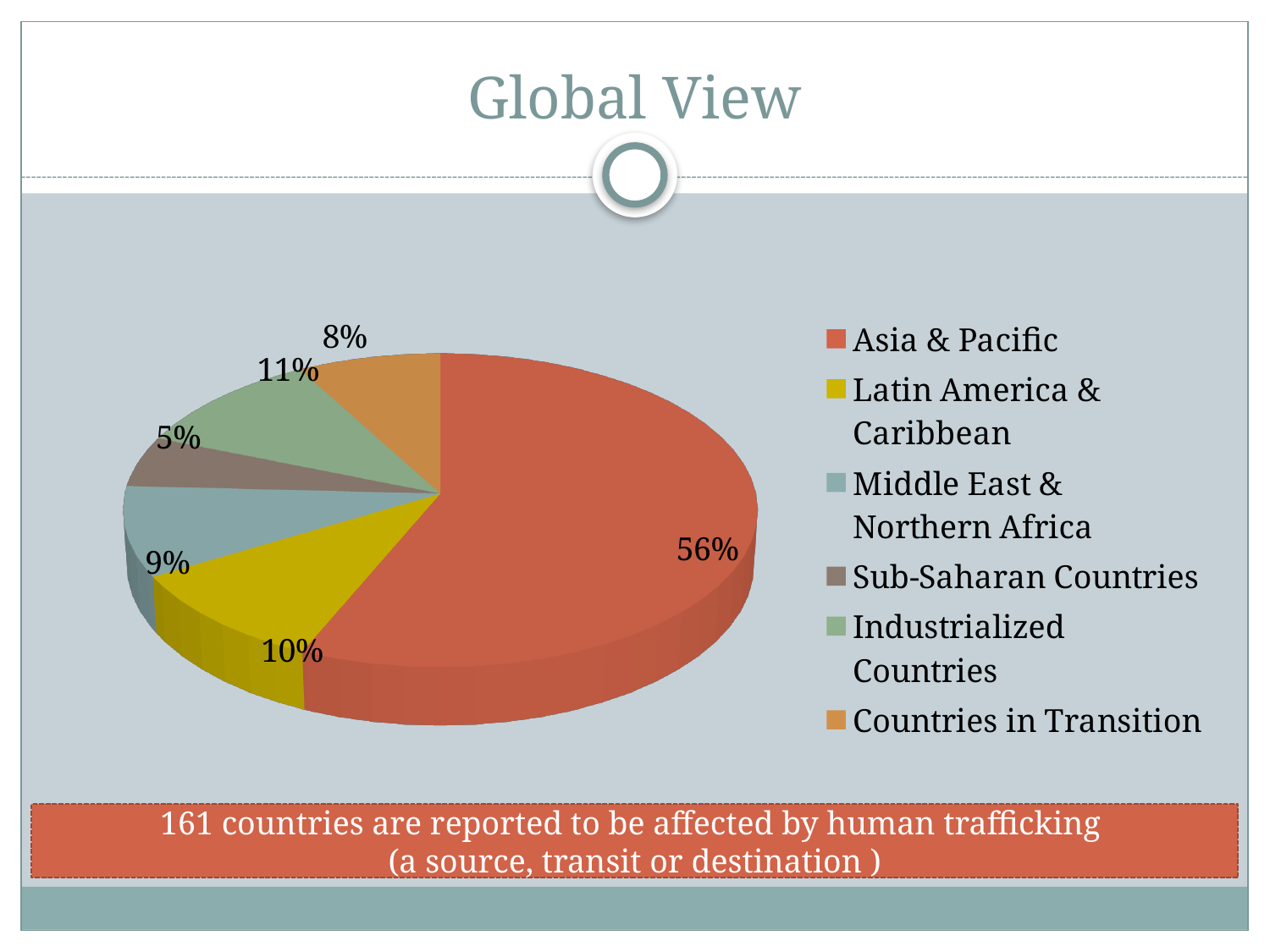
What percentage is shown for Middle East & Northern Africa? 9% Which region has the smallest slice of the pie? Sub-Saharan Countries What share of the pie does Asia & Pacific hold? 56% How many regions are shown in the pie chart? 6 What percentage is shown for Industrialized Countries? 11% What is the difference in percentage points between Asia & Pacific and Industrialized Countries? 45 What type of chart is shown on the slide? Pie chart What percentage is shown for Sub-Saharan Countries? 5% What percentage is shown for Countries in Transition? 8% Which region has the largest slice of the pie? Asia & Pacific What percentage is shown for Latin America & Caribbean? 10% Which is larger, the share for Industrialized Countries or the share for Countries in Transition? Industrialized Countries